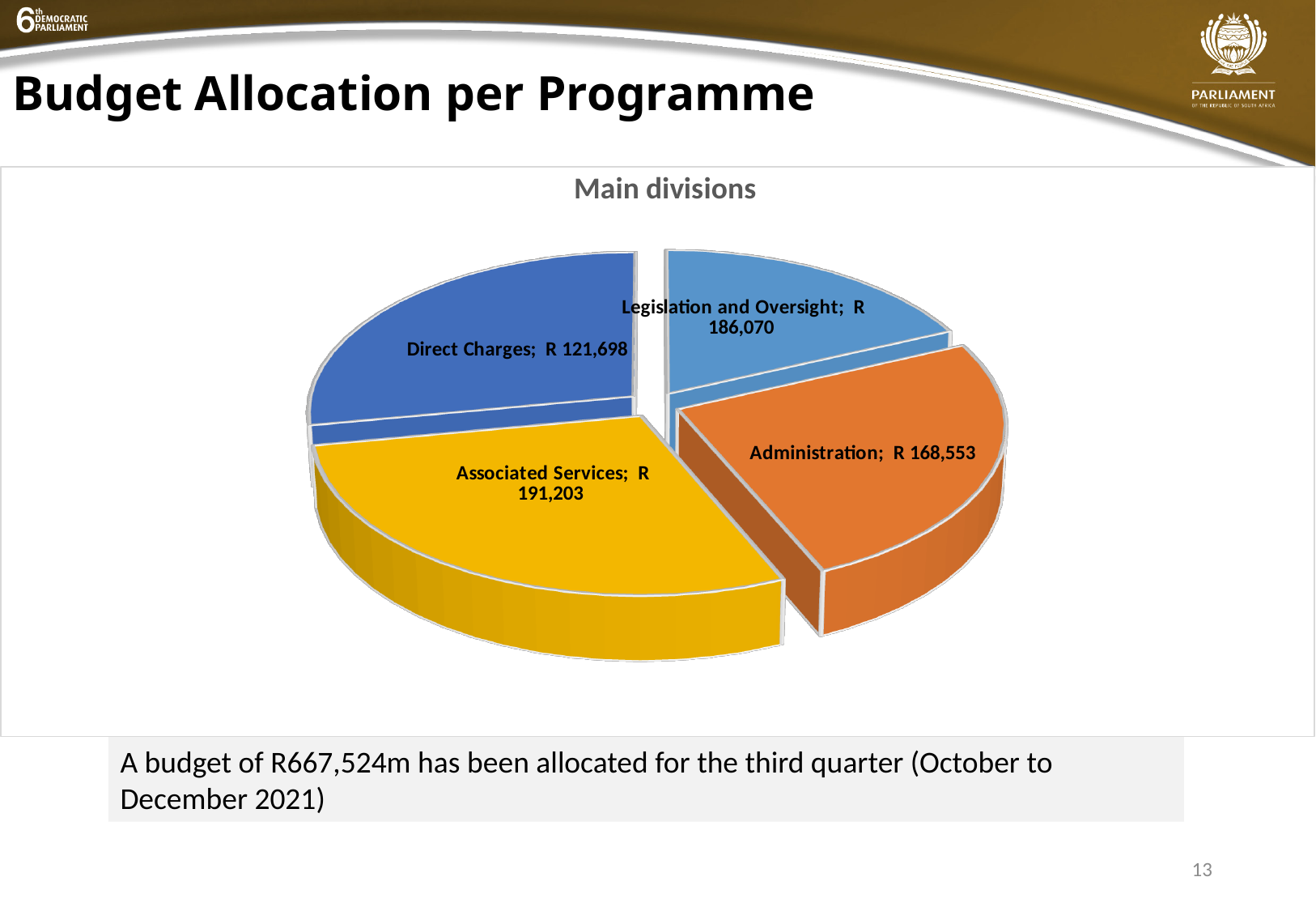
Which division has the smallest slice in the pie chart? Direct Charges What is the value for Associated Services in the pie chart? R 191,203 What is the difference between the values for Associated Services and Direct Charges? R 69,505 How many divisions are shown in the pie chart? 4 What kind of chart is shown on the slide? Pie chart What is the value for Direct Charges in the pie chart? R 121,698 What is the difference between the values for Legislation and Oversight and Administration? R 17,517 What is the value for Legislation and Oversight in the pie chart? R 186,070 Which division has the largest slice in the pie chart? Associated Services What is the value for Administration in the pie chart? R 168,553 Which is larger, the value for Legislation and Oversight or the value for Administration? Legislation and Oversight What is the title of the chart? Main divisions